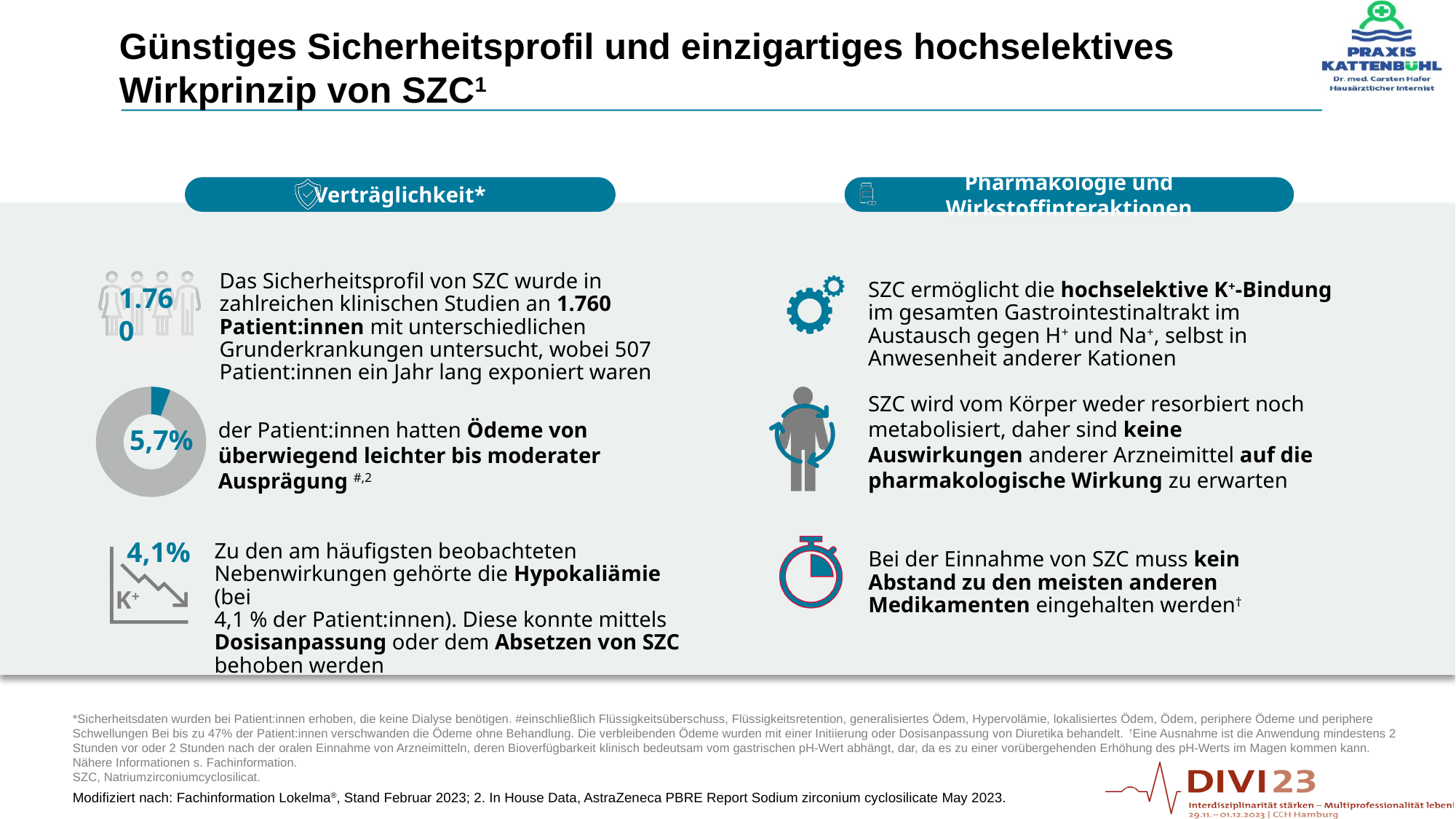
What kind of chart is shown next to the text about Ödeme on the left side of the slide? donut chart What percentage is printed in the centre of the donut chart on the left side of the slide? 5,7% How many distinct segments does the donut chart on the left side of the slide show? 2 What colour is the slice of the donut chart that represents the 5,7% of patients with Ödeme? blue Which part of the donut chart is larger: the blue slice or the grey remainder? the grey remainder According to the donut chart, what share of patients had Ödeme? 5,7% Is the highlighted (blue) slice of the donut chart greater or less than 50% of the ring? less